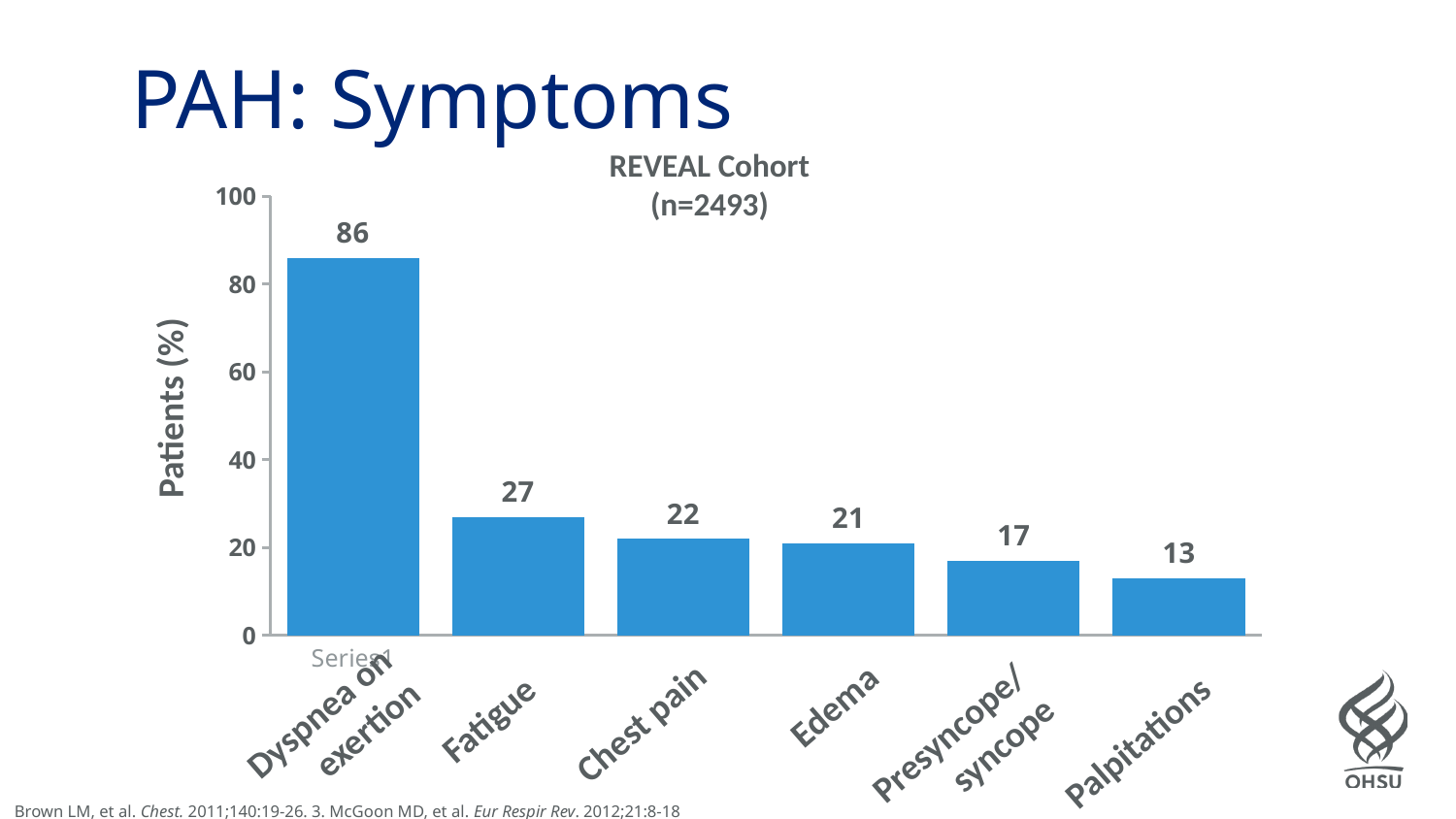
What percentage of patients reported Edema? 21 Which symptom has the lowest percentage of patients? Palpitations What is the value for Fatigue? 27 What is the difference between the values for Dyspnea on exertion and Fatigue? 59 Which is larger, the value for Presyncope/syncope or the value for Edema? Edema What is the label of the y axis? Patients (%) What percentage of patients reported dyspnea on exertion? 86 What kind of chart is shown on the slide? Bar chart Is the value for Fatigue greater or less than 40? less Which symptom has the highest percentage of patients? Dyspnea on exertion How many symptom categories are shown in the chart? 6 What is the difference between the values for Chest pain and Palpitations? 9